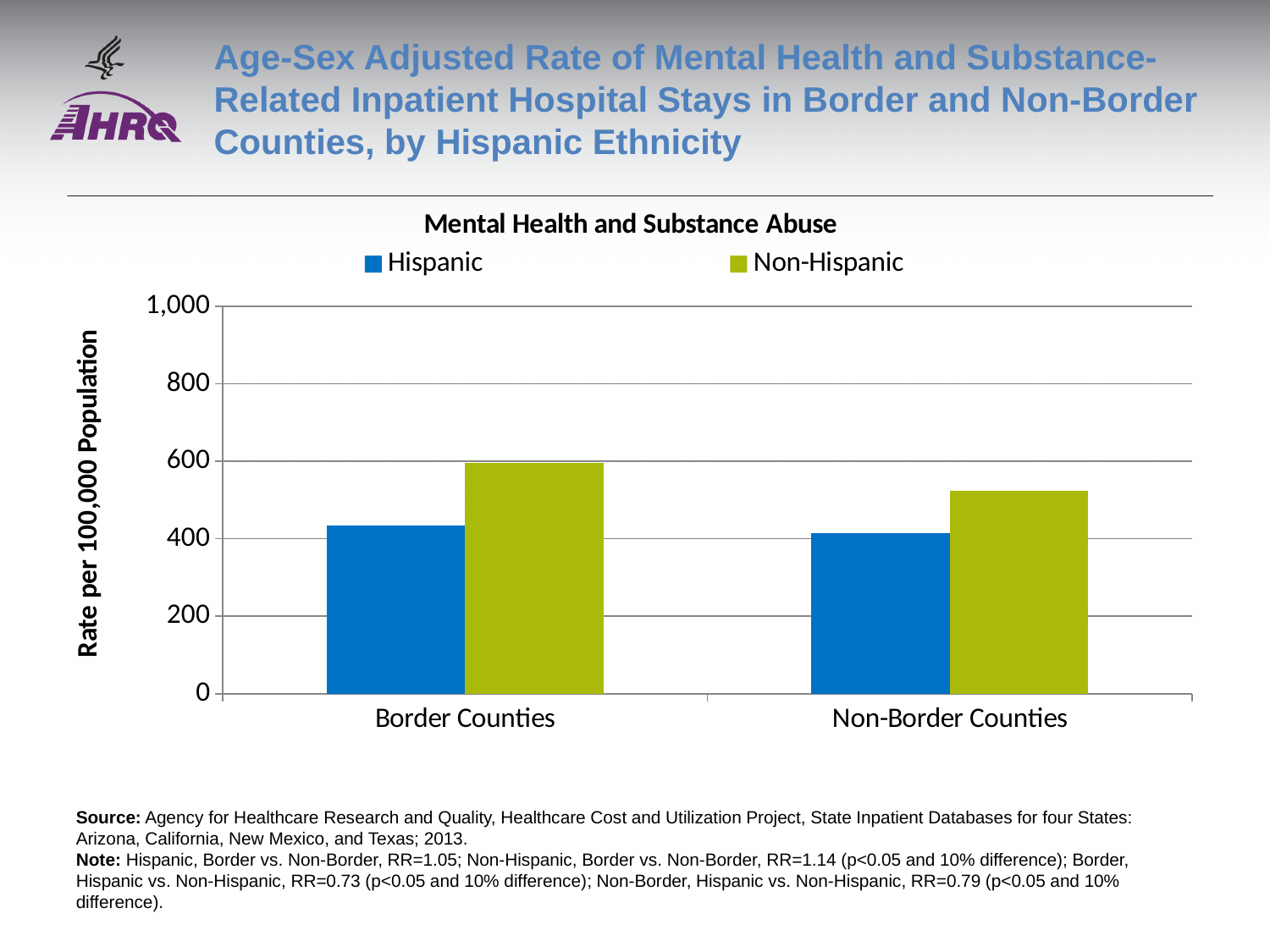
For the Non-Hispanic series, which is larger: Border Counties or Non-Border Counties? Border Counties Which bar is the highest in the chart? Non-Hispanic, Border Counties How many series does the legend list? 2 How many county categories are shown on the x axis? 2 Is the Hispanic value for Border Counties greater or less than 600? less Is the Non-Hispanic value for Border Counties greater or less than 400? greater What is the label of the vertical axis? Rate per 100,000 Population In Border Counties, which is larger: the Hispanic rate or the Non-Hispanic rate? Non-Hispanic What is the title of the chart? Mental Health and Substance Abuse In Non-Border Counties, which is larger: the Hispanic rate or the Non-Hispanic rate? Non-Hispanic What kind of chart is shown on the slide? Bar chart Is the Non-Hispanic value for Non-Border Counties greater or less than 600? less